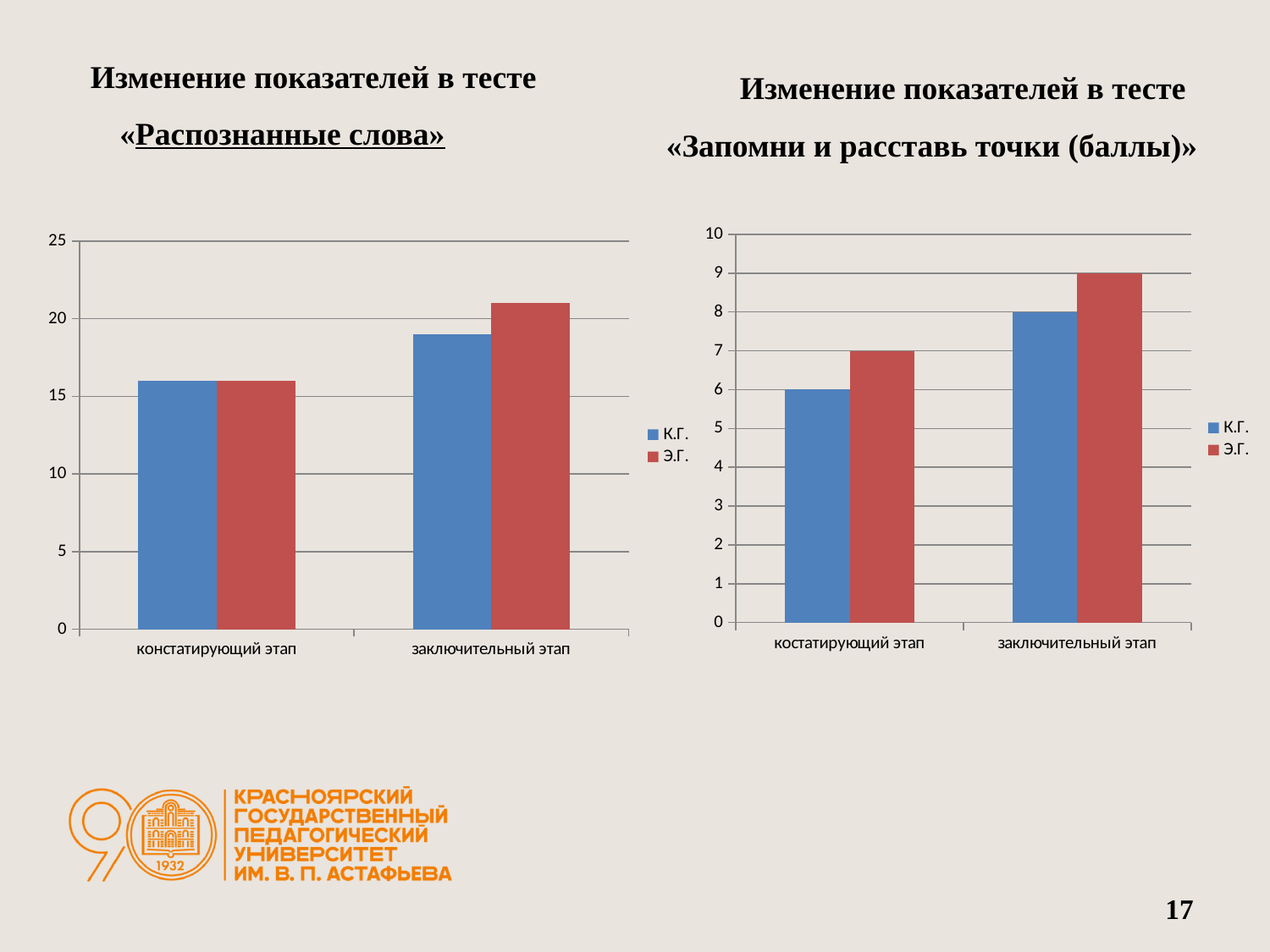
How many series does the legend of the chart «Запомни и расставь точки (баллы)» list? 2 How many categories are shown on the x axis of the chart «Распознанные слова»? 2 In the chart «Распознанные слова», is the value for Э.Г. at the заключительный этап greater or less than 20? greater In the chart «Запомни и расставь точки (баллы)», what is the value for Э.Г. at the заключительный этап? 9 In the chart «Распознанные слова», at the заключительный этап, which series has the larger value, К.Г. or Э.Г.? Э.Г. In the chart «Запомни и расставь точки (баллы)», which bar is the lowest? К.Г. at the костатирующий этап In the chart «Запомни и расставь точки (баллы)», which bar is the highest? Э.Г. at the заключительный этап In the chart «Запомни и расставь точки (баллы)», what is the difference between the Э.Г. value at the заключительный этап and the К.Г. value at the костатирующий этап? 3 In the chart «Запомни и расставь точки (баллы)», what is the value for К.Г. at the костатирующий этап? 6 In the chart «Распознанные слова», is the value for К.Г. at the констатирующий этап greater or less than 20? less In the chart «Запомни и расставь точки (баллы)», what is the value for Э.Г. at the костатирующий этап? 7 What kind of chart is the chart «Распознанные слова»? bar chart